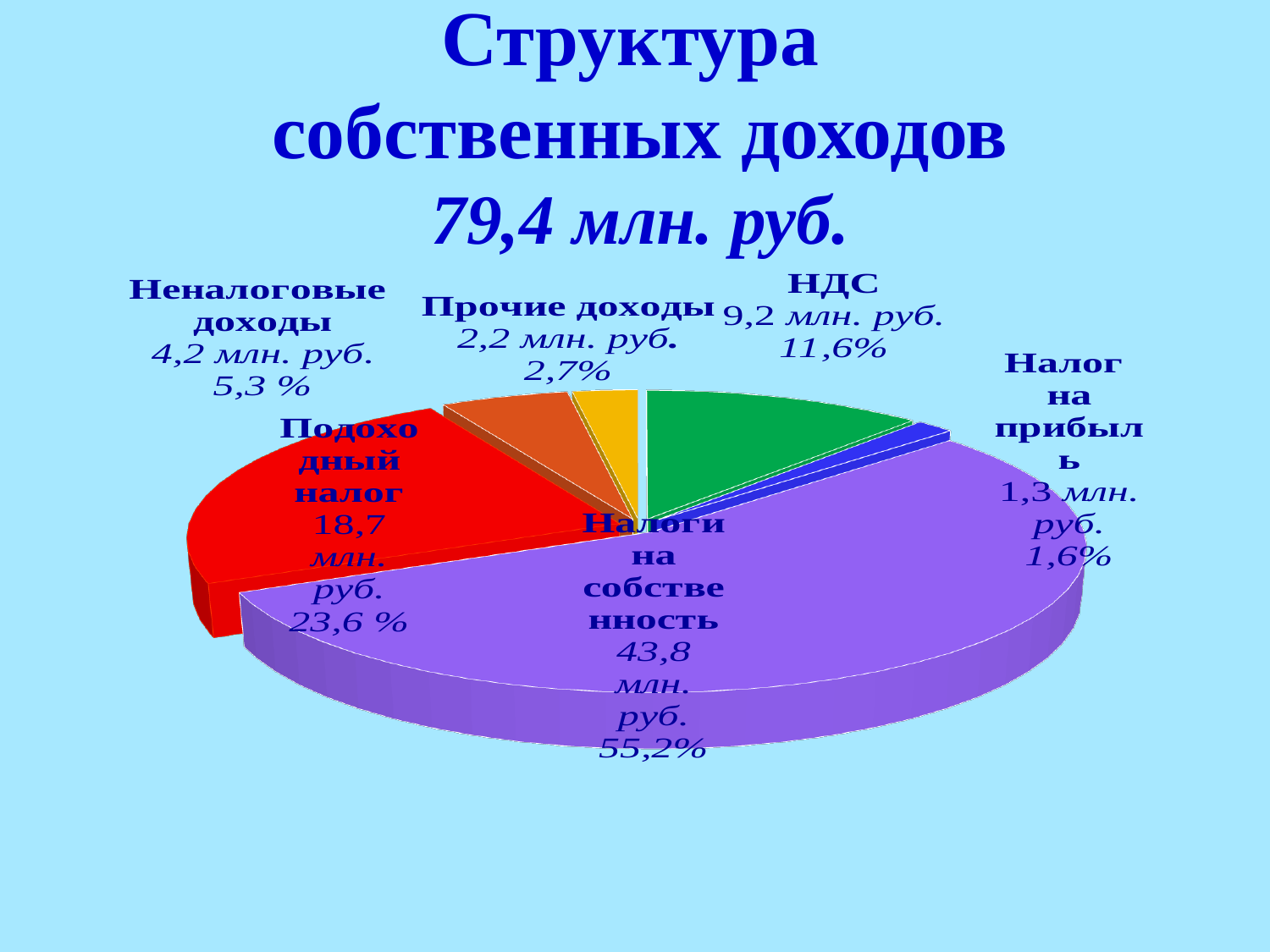
What is the difference in млн. руб. between Налоги на собственность and Подоходный налог? 25,1 млн. руб. Which category has the smallest slice of the pie? Налог на прибыль Which is larger, Неналоговые доходы or Прочие доходы? Неналоговые доходы What is the value in млн. руб. for Подоходный налог? 18,7 млн. руб. What kind of chart is shown on the slide? pie chart How many slices does the pie chart have? 6 What is the value in млн. руб. for Налог на прибыль? 1,3 млн. руб. What total amount is stated in the chart title? 79,4 млн. руб. Which category has the largest slice of the pie? Налоги на собственность What share of the pie does Налоги на собственность represent? 55,2% What is the value in млн. руб. for Налоги на собственность? 43,8 млн. руб. What percentage share is shown for НДС? 11,6%